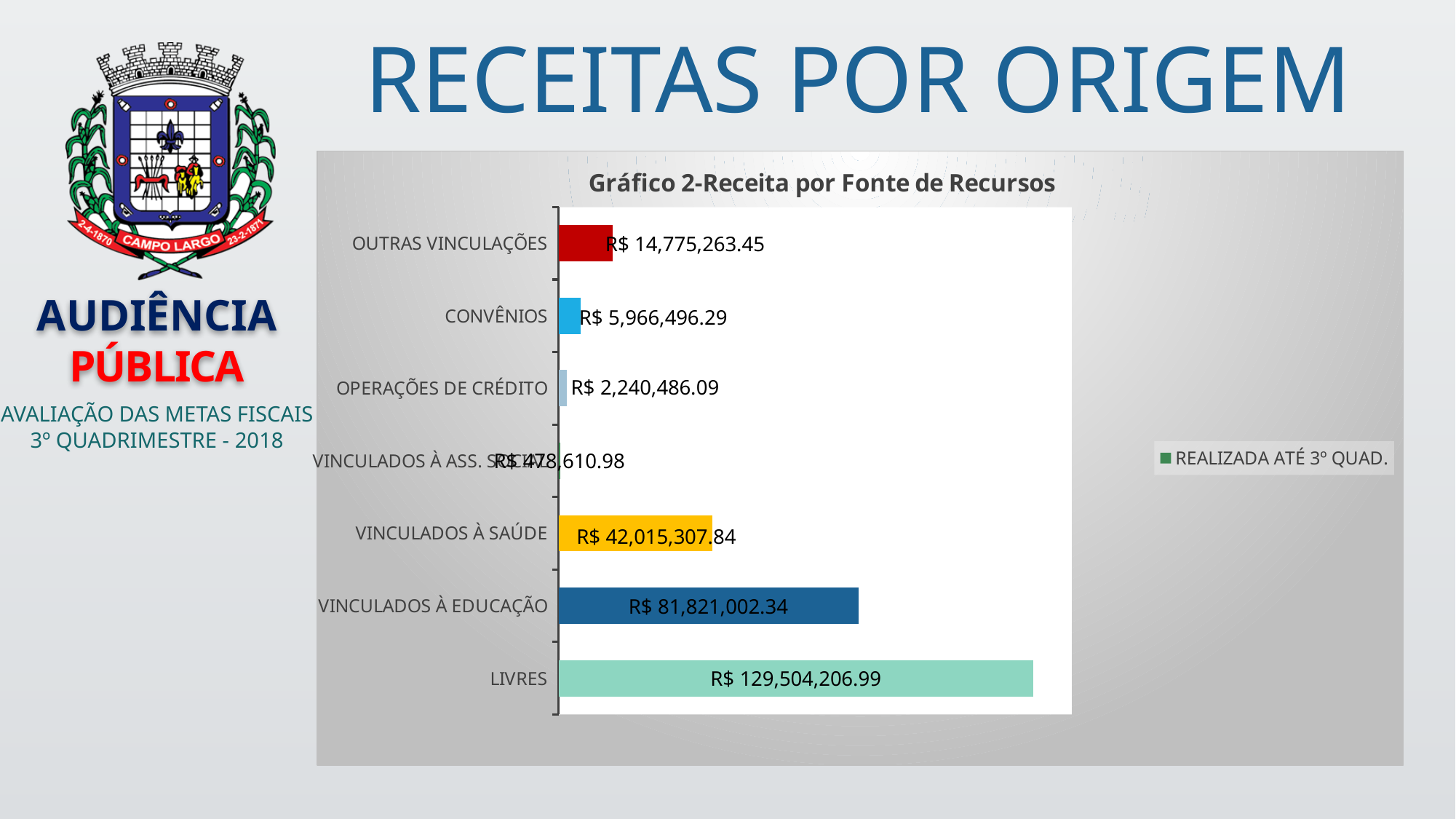
What is the value for OPERAÇÕES DE CRÉDITO in Gráfico 2? R$ 2,240,486.09 What is the legend entry shown in Gráfico 2? REALIZADA ATÉ 3º QUAD. What is the value for VINCULADOS À SAÚDE in Gráfico 2? R$ 42,015,307.84 Which category has the highest value in Gráfico 2? LIVRES What is the value for LIVRES in Gráfico 2? R$ 129,504,206.99 What is the difference between LIVRES and VINCULADOS À EDUCAÇÃO in Gráfico 2? R$ 47,683,204.65 What is the value for VINCULADOS À EDUCAÇÃO in Gráfico 2? R$ 81,821,002.34 What is the value for CONVÊNIOS in Gráfico 2? R$ 5,966,496.29 What type of chart is Gráfico 2-Receita por Fonte de Recursos? Bar chart Which is larger in Gráfico 2, VINCULADOS À EDUCAÇÃO or VINCULADOS À SAÚDE? VINCULADOS À EDUCAÇÃO What is the value for OUTRAS VINCULAÇÕES in Gráfico 2? R$ 14,775,263.45 How many series does the legend of Gráfico 2 list? 1